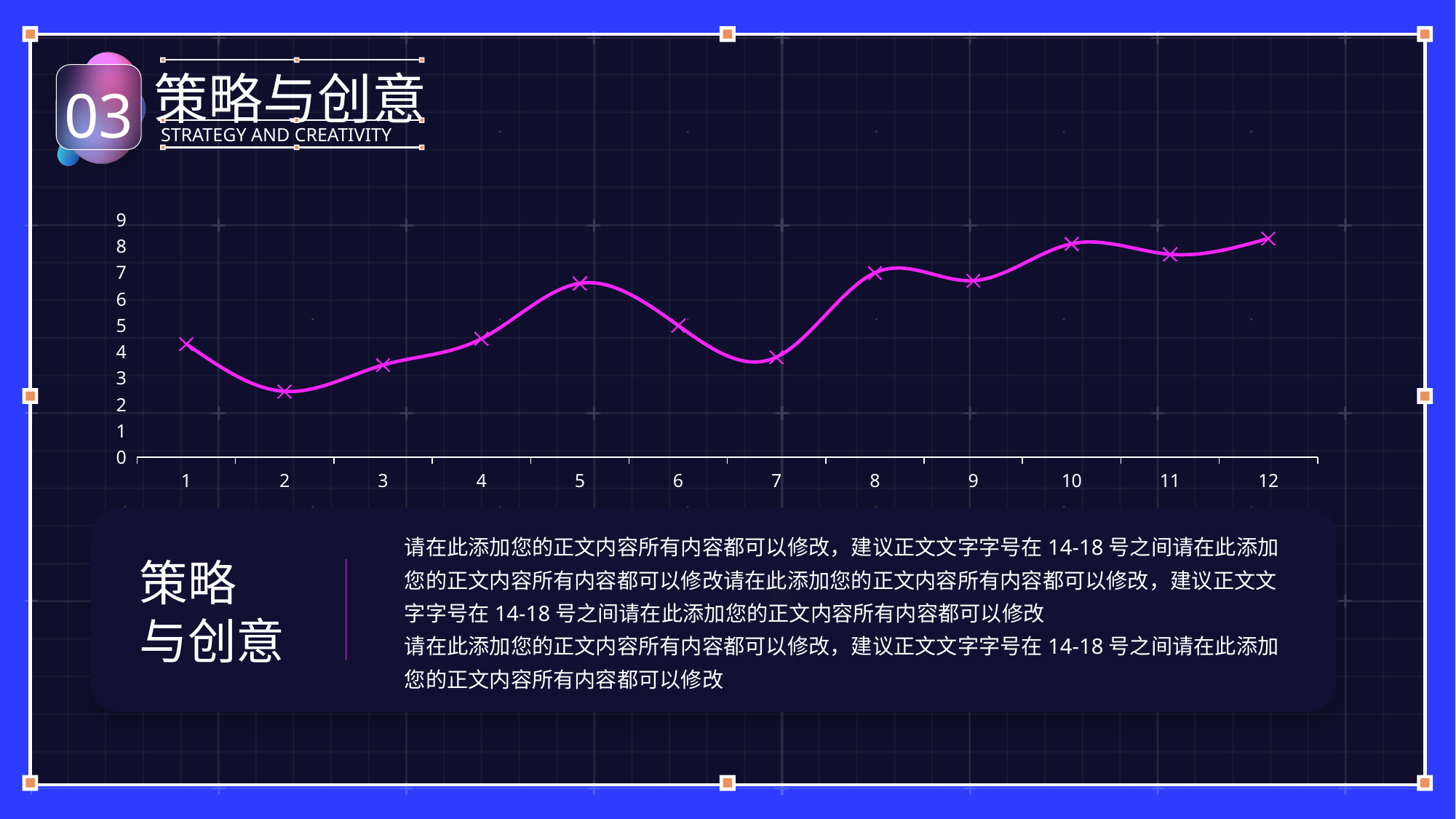
Which x-axis category has the lowest value on the line chart? 2 Is the value at x = 11 greater or less than 7? greater Which has the larger value, x = 5 or x = 2? 5 Is the value at x = 5 greater or less than 6? greater How many data points are plotted on the line chart? 12 Is the value at x = 12 greater or less than 8? greater Which has the larger value, x = 8 or x = 7? 8 Does the line rise or fall from x = 2 to x = 5? rise What kind of chart is shown on the slide? line chart What colour is the plotted line on the chart? magenta (pink)